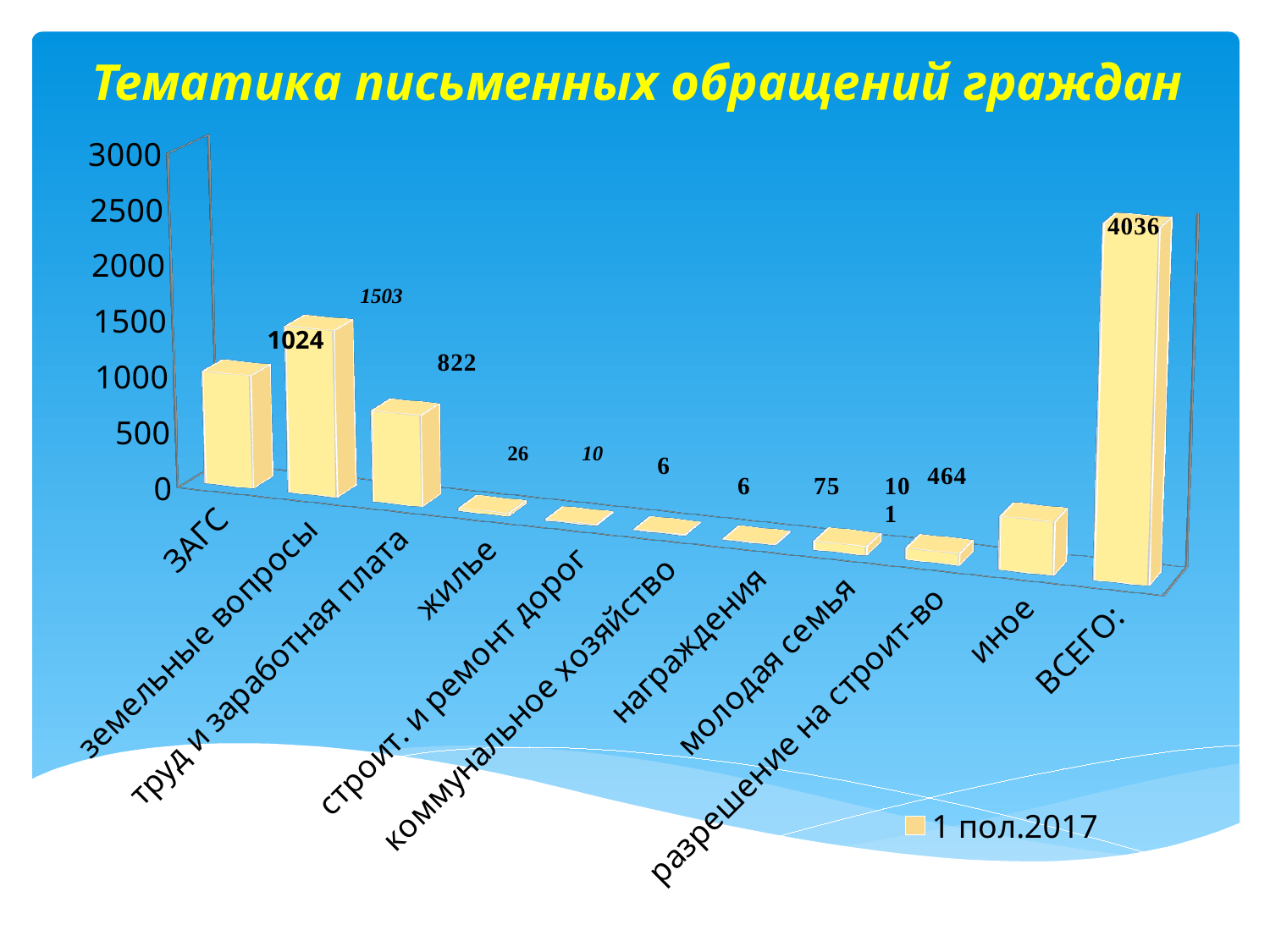
What is the value for труд и заработная плата? 822 What type of chart is shown? bar chart Is the value for труд и заработная плата greater or less than 1000? less How many series does the legend list? 1 What is the difference between земельные вопросы and ЗАГС? 479 What is the value for иное? 464 What is the value for молодая семья? 75 Which is larger, the value for жилье or the value for иное? иное What is the value for земельные вопросы? 1503 How many categories are shown on the x axis? 11 Which category has the highest value? ВСЕГО: What is the value for ЗАГС? 1024